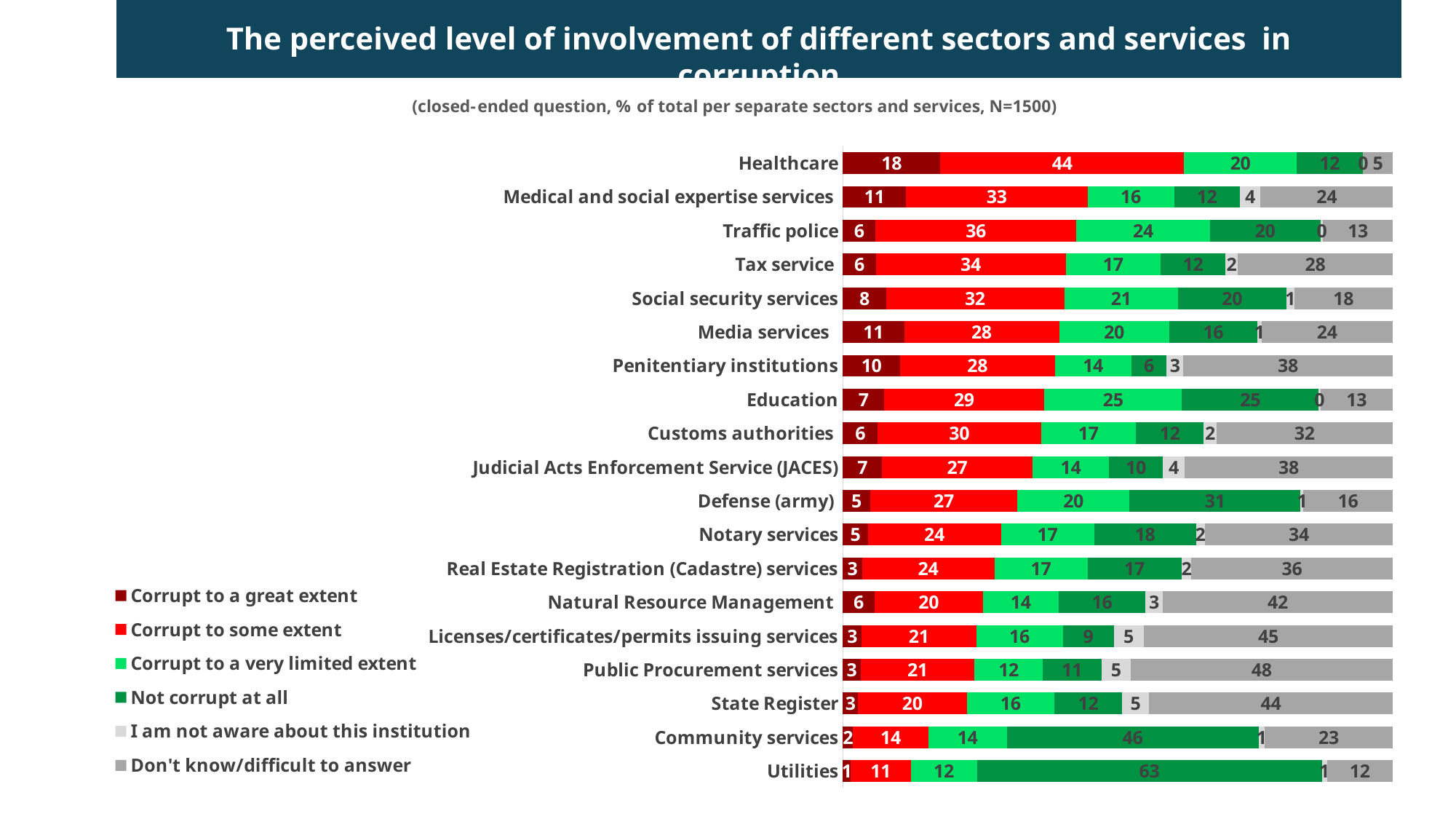
What is the value for 'Not corrupt at all' for Utilities? 63 How many series does the legend list? 6 Which sector has the highest value for 'Corrupt to a great extent'? Healthcare What is the difference between the 'Corrupt to some extent' values for Healthcare and Traffic police? 8 How many sectors and services are plotted on the chart? 19 Which sector has the lowest value for 'Don't know/difficult to answer'? Healthcare What is the value for 'Corrupt to some extent' for Healthcare? 44 Which has a larger 'Not corrupt at all' value, Defense (army) or Education? Defense (army) What kind of chart is shown on the slide? Stacked bar chart What colour represents 'Don't know/difficult to answer' in the legend? Grey What is the value for 'Don't know/difficult to answer' for Public Procurement services? 48 Which sector has the highest value for 'Not corrupt at all'? Utilities